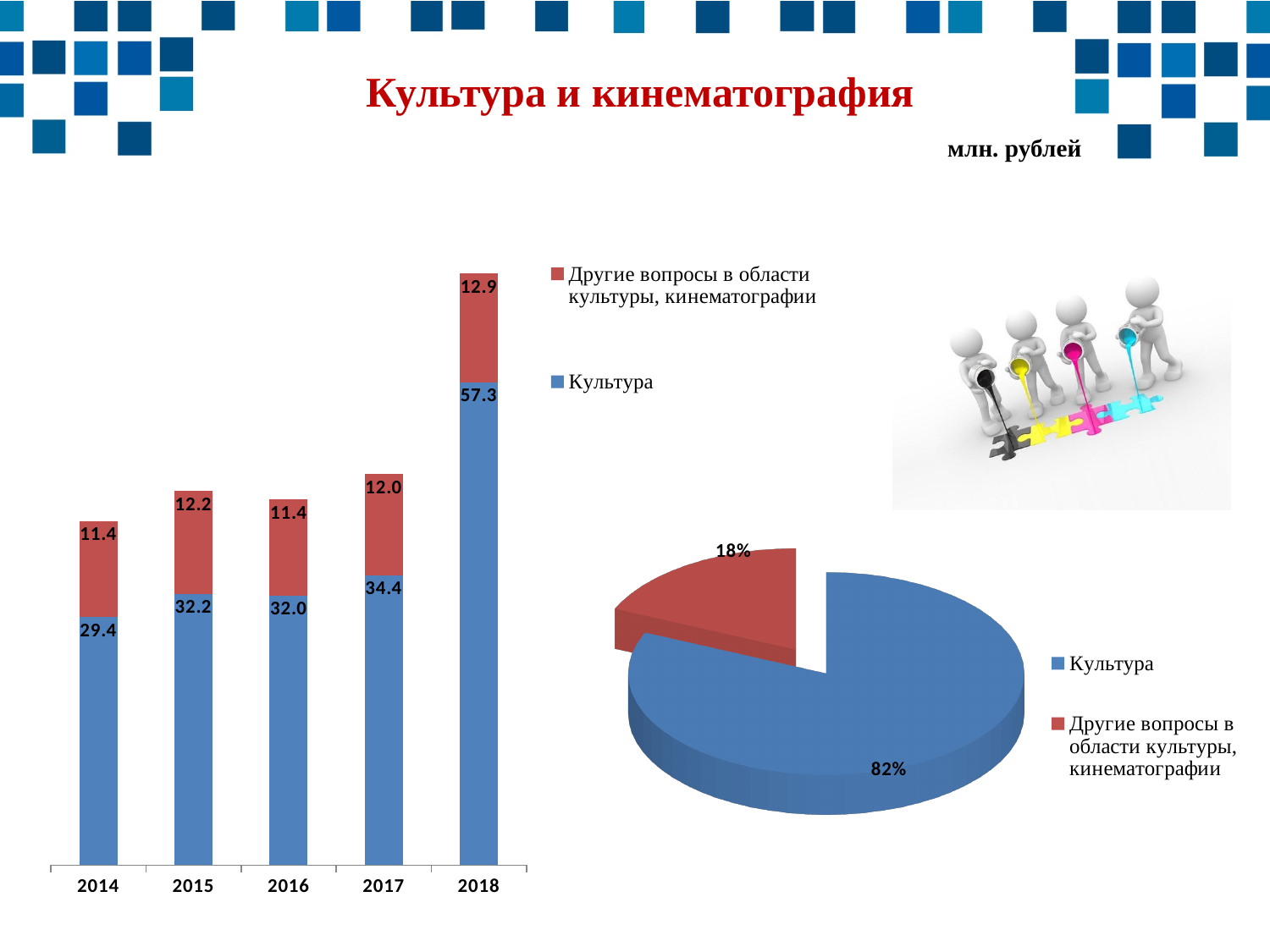
In the stacked bar chart on the left, what is the value for Другие вопросы в области культуры, кинематографии in 2015? 12.2 In the stacked bar chart on the left, what is the total of the 2014 bar? 40.8 In the stacked bar chart on the left, is the Культура value larger in 2015 or in 2016? 2015 In the pie chart on the right, what share does Культура have? 82% In the stacked bar chart on the left, what is the total of the 2018 bar? 70.2 In the stacked bar chart on the left, what is the value for Культура in 2018? 57.3 In the stacked bar chart on the left, which year has the highest value for Культура? 2018 In the stacked bar chart on the left, what is the difference between the Культура values for 2018 and 2017? 22.9 What kind of chart is the chart on the right of the slide? Pie chart In the stacked bar chart on the left, which year has the lowest value for Культура? 2014 How many years are shown on the x axis of the stacked bar chart on the left? 5 How many series does the legend of the stacked bar chart on the left list? 2